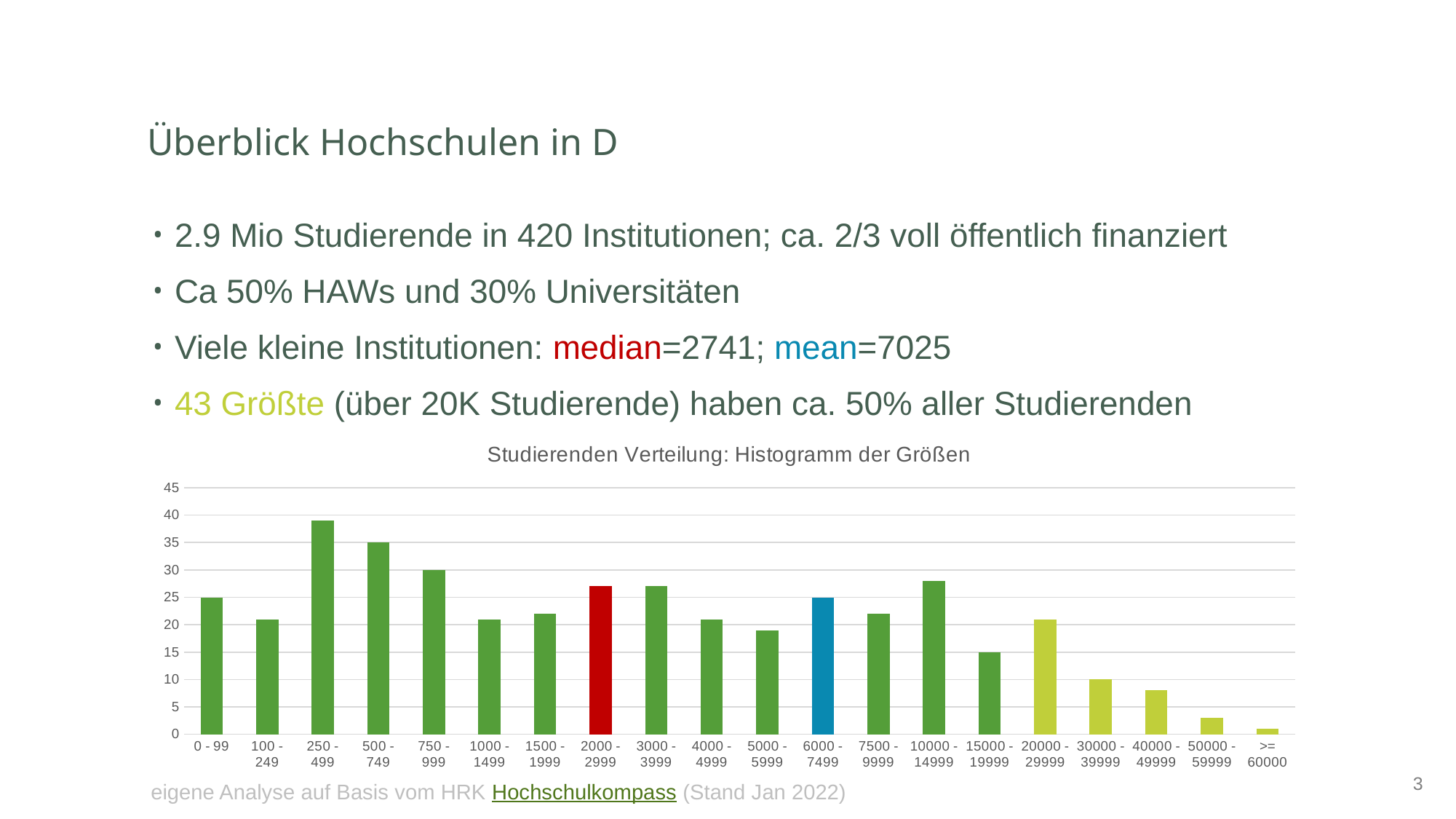
Is the value for 250 - 499 greater or less than 35? greater Which size category has the lowest bar in the chart? >= 60000 What is the title of the chart? Studierenden Verteilung: Histogramm der Größen What kind of chart is shown on the slide? bar chart How many size categories are shown on the x axis of the chart? 20 Which size category has the highest bar in the chart? 250 - 499 Is the value for 10000 - 14999 greater or less than 25? greater Is the value for 40000 - 49999 greater or less than 10? less What colour is the bar for the 2000 - 2999 category? red Do the bar values rise or fall from 10000 - 14999 to >= 60000? fall Which bar is taller: 250 - 499 or 500 - 749? 250 - 499